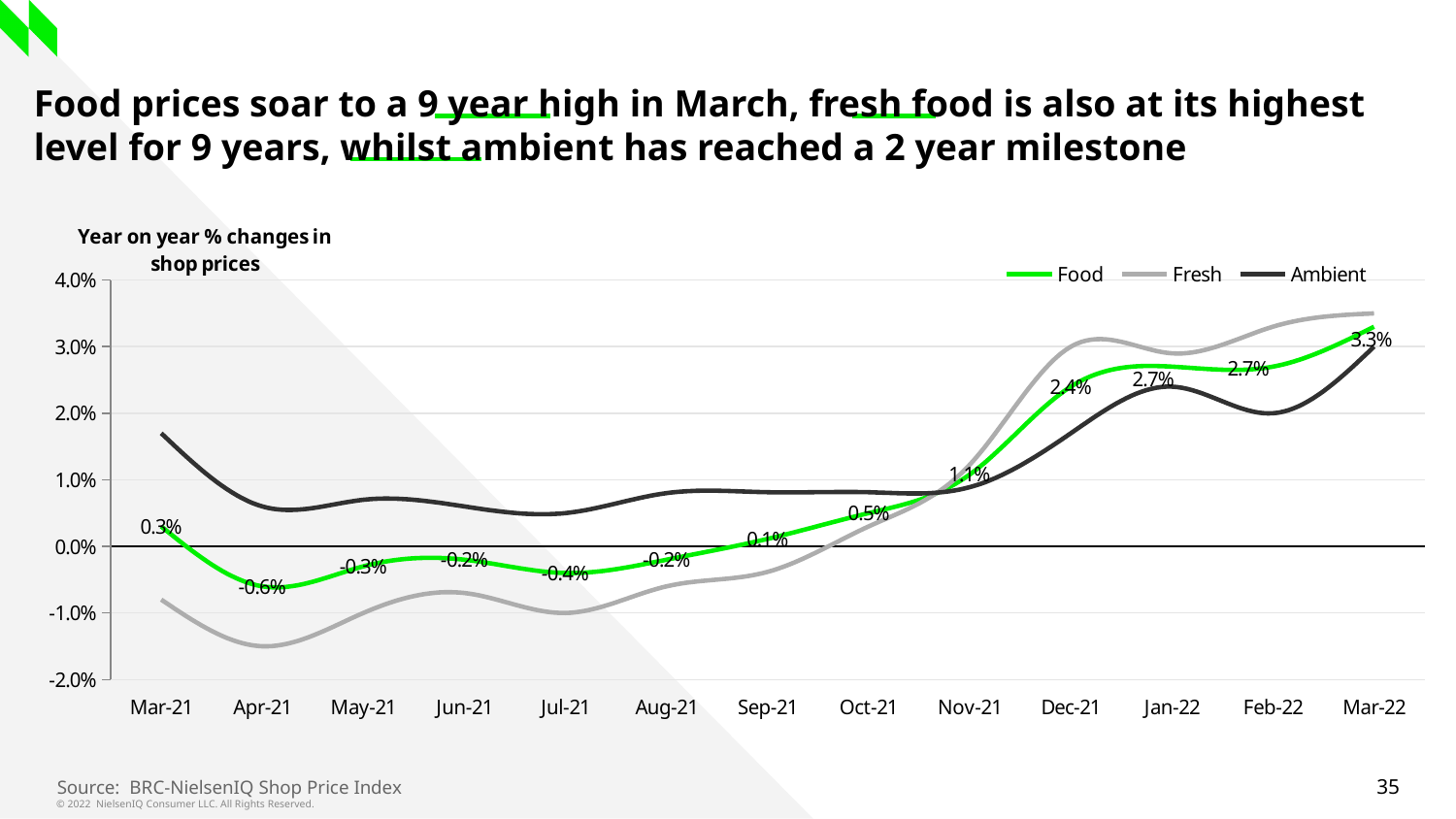
How many series does the legend list? 3 In which month is the Food series at its lowest? Apr-21 What is the difference between the Food values for Mar-22 and Dec-21? 0.9% How many months are plotted along the x axis? 13 Which is larger, the Food value for Oct-21 or for Sep-21? Oct-21 What is the Food value for Mar-22? 3.3% What is the Food value for Apr-21? -0.6% Is the Fresh value for Apr-21 greater or less than -1.0%? less What is the Food value for Nov-21? 1.1% In which month is the Food series at its highest? Mar-22 Is the Fresh value for Mar-22 greater or less than 3.0%? greater What type of chart is shown on the slide? line chart